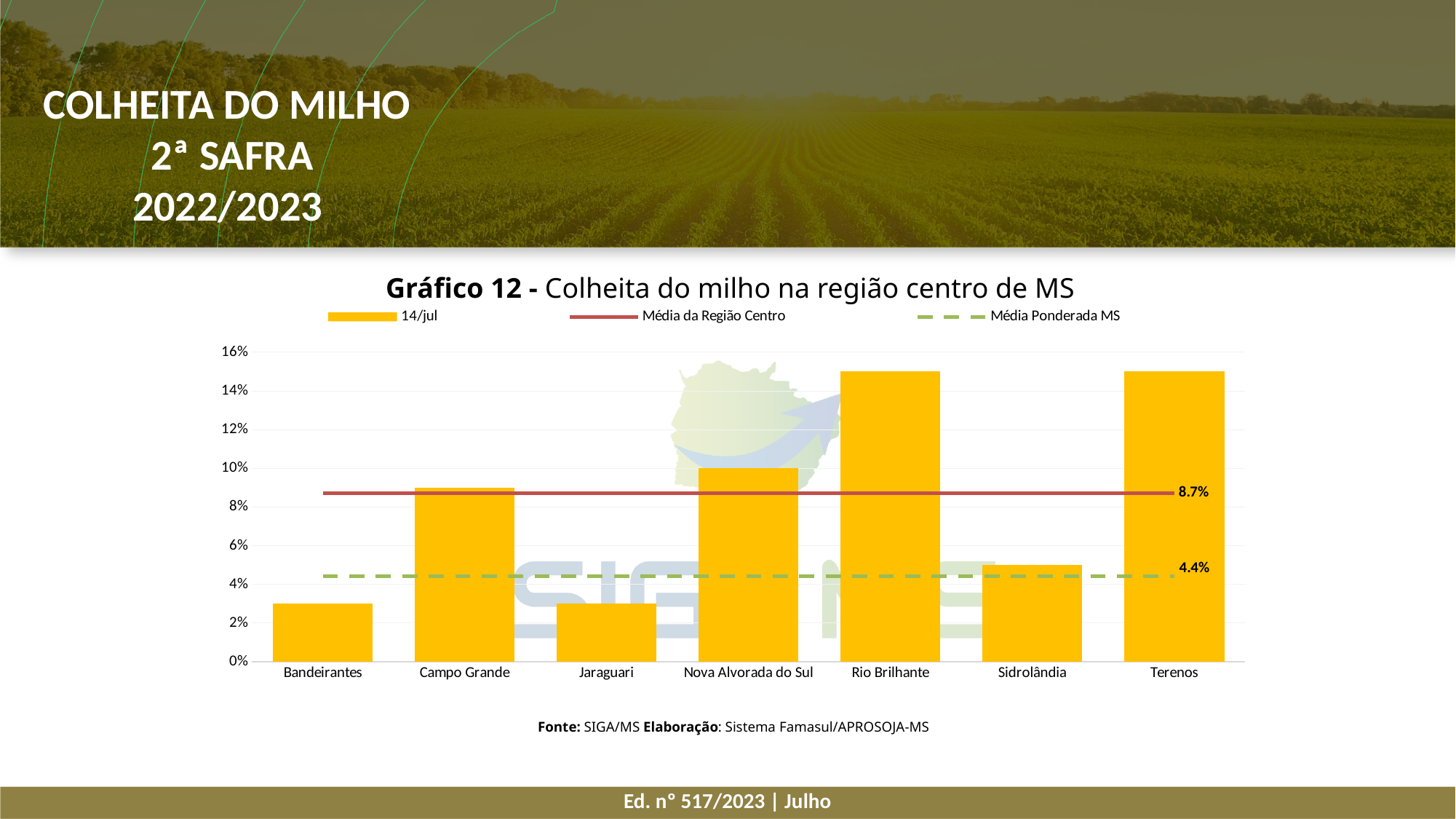
What is the difference between the Média da Região Centro (8.7%) and the Média Ponderada MS (4.4%)? 4.3 percentage points What is the title of the chart? Gráfico 12 - Colheita do milho na região centro de MS Is the value for Campo Grande greater or less than 8%? greater How many series does the legend list? 3 Is the value for Sidrolândia greater or less than 6%? less Which has the larger value, Nova Alvorada do Sul or Sidrolândia? Nova Alvorada do Sul Which has the larger value, Campo Grande or Jaraguari? Campo Grande How many municipalities are shown on the x axis of the chart? 7 What kind of chart is used to show the 14/jul values? Bar chart Is the value for Rio Brilhante greater or less than 14%? greater What value is labelled for the Média Ponderada MS line? 4.4% What value is labelled for the Média da Região Centro line? 8.7%